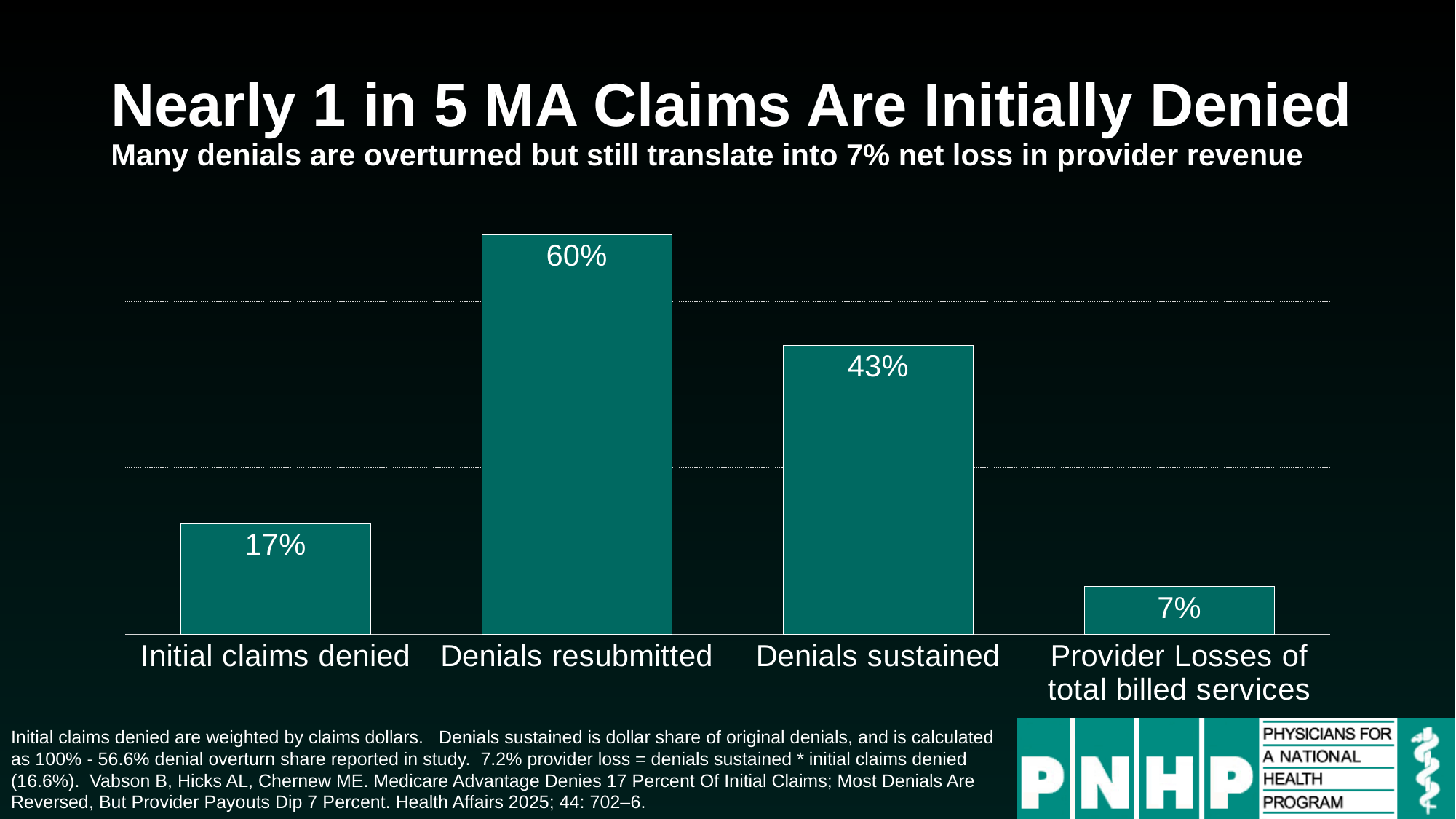
What is the value for Denials resubmitted? 60% What kind of chart is shown on the slide? Bar chart Which is larger, Initial claims denied or Denials sustained? Denials sustained What is the difference between Denials resubmitted and Denials sustained? 17% What is the value for Initial claims denied? 17% What is the value for Denials sustained? 43% How many categories are shown in the chart? 4 Which category has the highest value? Denials resubmitted Which category has the lowest value? Provider Losses of total billed services What is the value for Provider Losses of total billed services? 7% What is the title of the slide? Nearly 1 in 5 MA Claims Are Initially Denied What is the difference between Initial claims denied and Provider Losses of total billed services? 10%